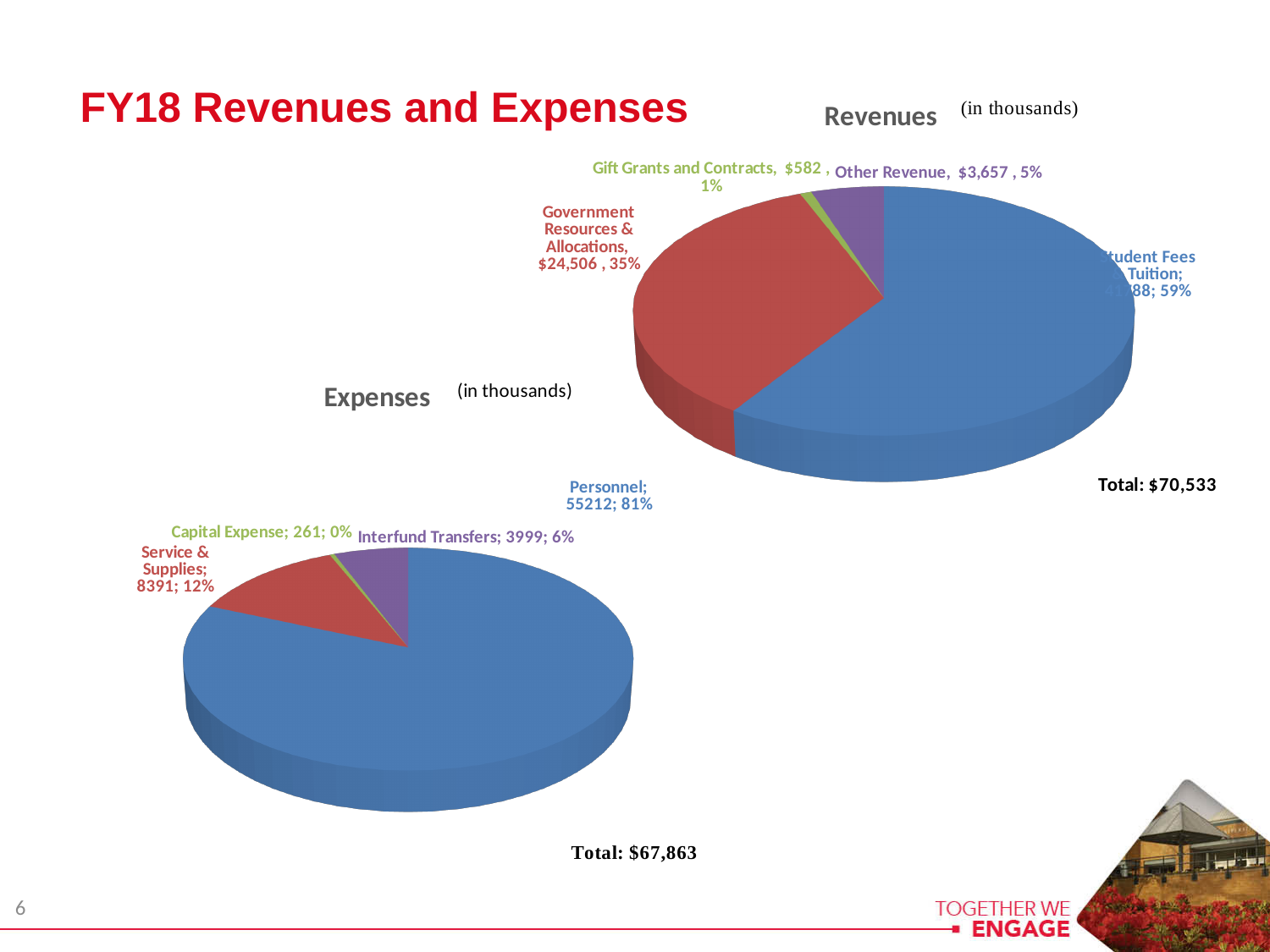
In the Revenues chart, what is the value for Gift Grants and Contracts? $582 In the Expenses chart, what is the value for Service & Supplies? 8391 In the Revenues chart, which category is the largest? Student Fees & Tuition In the Expenses chart, what is the value for Personnel? 55212 In the Revenues chart, what is the total shown? $70,533 In the Revenues chart, what is the value for Other Revenue? $3,657 In the Revenues chart, what is the value for Government Resources & Allocations? $24,506 In the Revenues chart, which category is the smallest? Gift Grants and Contracts In the Revenues chart, what share of the pie is Student Fees & Tuition? 59% In the Expenses chart, what is the difference between Interfund Transfers and Capital Expense? 3738 What kind of chart is the Expenses chart? Pie chart In the Expenses chart, how many categories are shown? 4